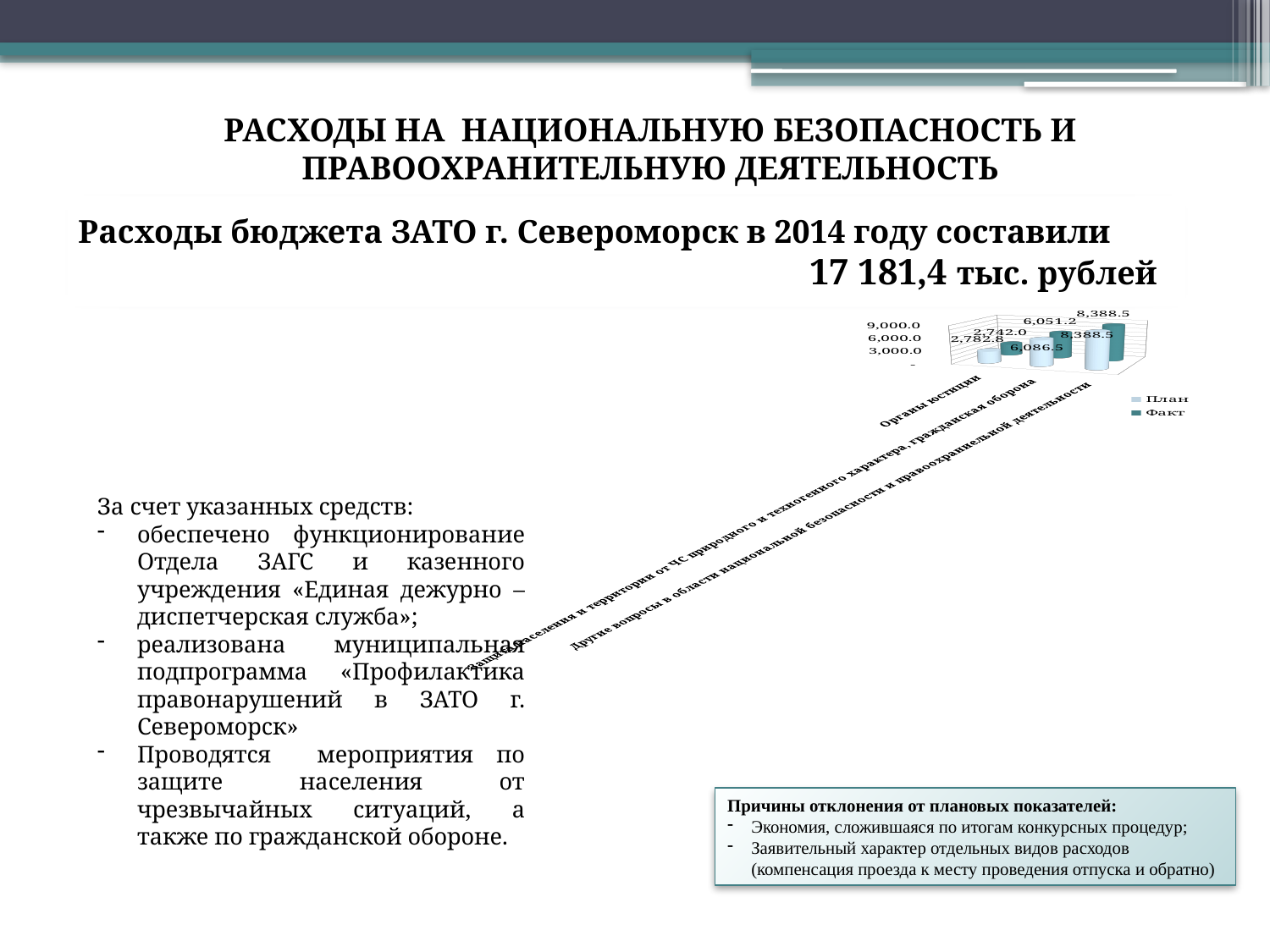
What is the Факт value for Органы юстиции? 2,742.0 What kind of chart is shown on the slide? bar chart For Органы юстиции, which is larger: План or Факт? План What is the План value for Другие вопросы в области национальной безопасности и правоохранительной деятельности? 8,388.5 Which category has the lowest Факт value? Органы юстиции Which category has the highest План value? Другие вопросы в области национальной безопасности и правоохранительной деятельности What are the two series named in the chart legend? План and Факт How many series does the chart legend list? 2 What is the difference between План and Факт for Органы юстиции? 40.8 How many categories are plotted on the chart? 3 What is the План value for Органы юстиции? 2,782.8 What is the Факт value for Другие вопросы в области национальной безопасности и правоохранительной деятельности? 8,388.5